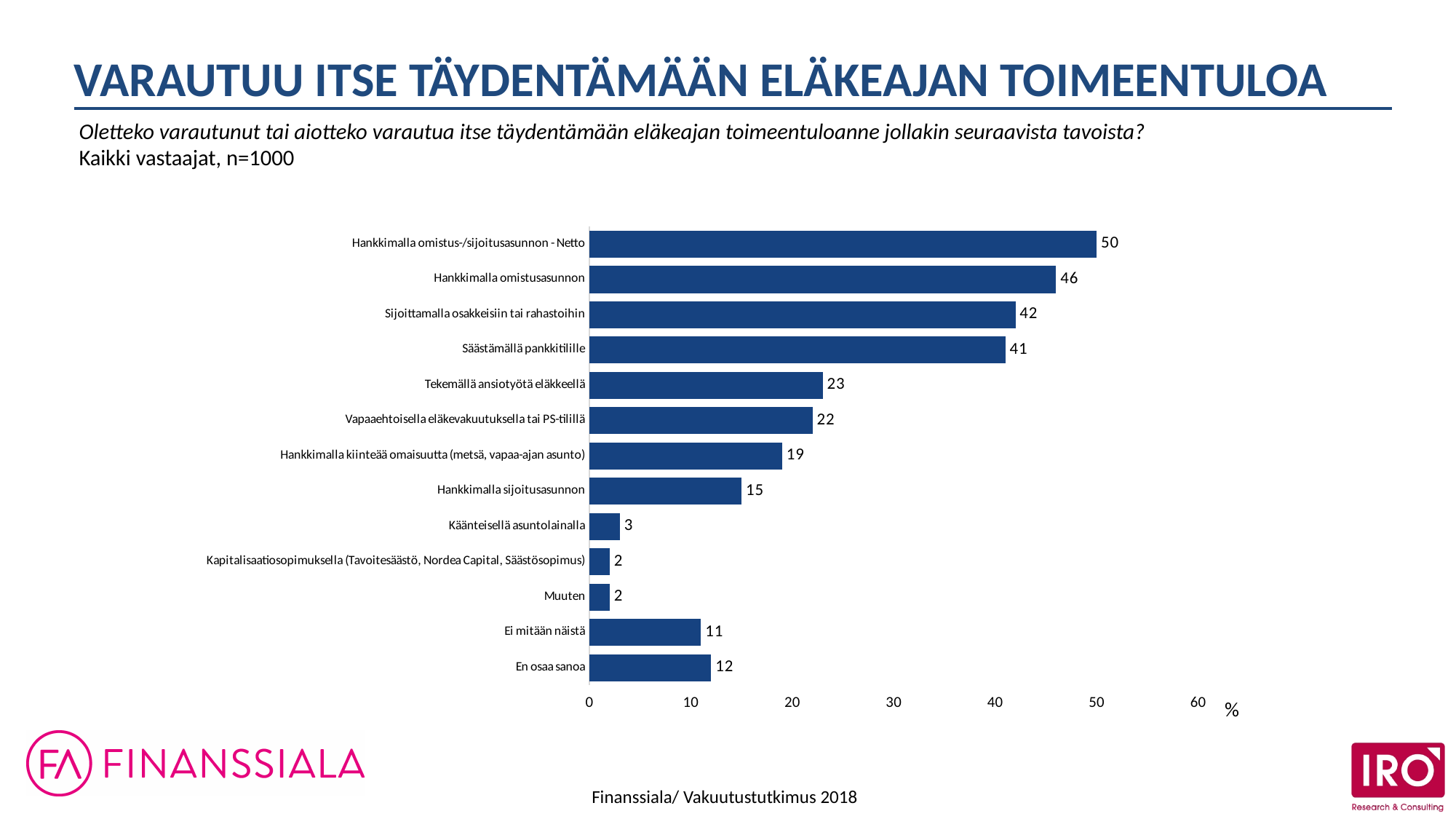
What is the difference between "Hankkimalla kiinteää omaisuutta (metsä, vapaa-ajan asunto)" and "Hankkimalla sijoitusasunnon"? 4 What is the value for "Käänteisellä asuntolainalla"? 3 Which is larger, the value for "Ei mitään näistä" or the value for "En osaa sanoa"? En osaa sanoa What unit is shown at the end of the horizontal axis? % Which category has the highest value? Hankkimalla omistus-/sijoitusasunnon - Netto What is the difference between "Sijoittamalla osakkeisiin tai rahastoihin" and "Säästämällä pankkitilille"? 1 Is the value for "Vapaaehtoisella eläkevakuutuksella tai PS-tilillä" greater or less than 30? less What kind of chart is shown on the slide? bar chart What is the value for "Hankkimalla omistusasunnon"? 46 What is the value for "Tekemällä ansiotyötä eläkkeellä"? 23 How many categories are shown in the chart? 13 What is the value for "En osaa sanoa"? 12